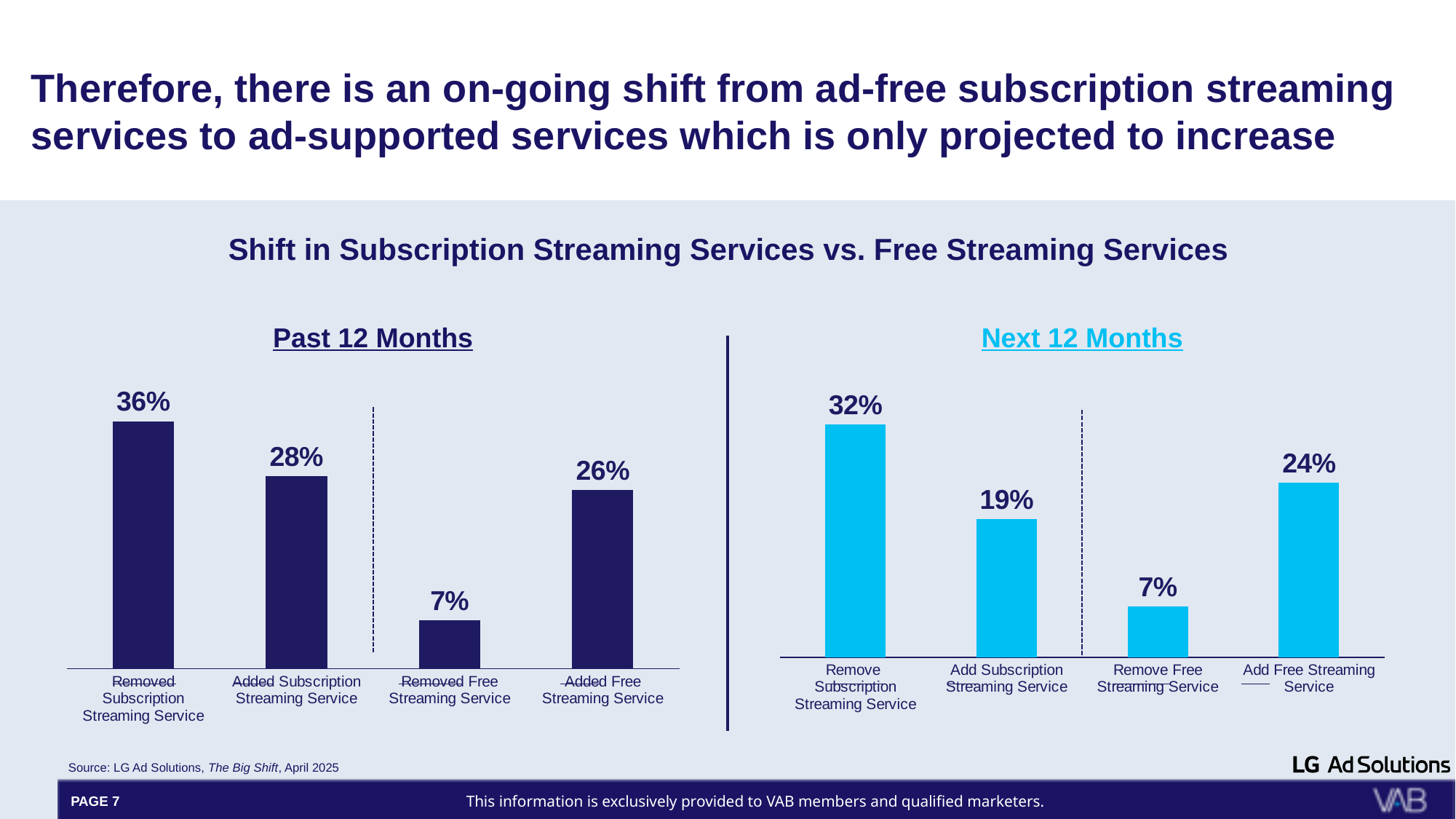
What colour are the bars in the Next 12 Months chart? Light blue In the Past 12 Months chart, which is larger: Added Subscription Streaming Service or Added Free Streaming Service? Added Subscription Streaming Service How many categories are shown in the Past 12 Months chart? 4 In the Next 12 Months chart, which is larger: Remove Subscription Streaming Service or Add Free Streaming Service? Remove Subscription Streaming Service What kind of chart is the Next 12 Months chart? Bar chart In the Past 12 Months chart, what is the value for Removed Subscription Streaming Service? 36% In the Next 12 Months chart, which category has the highest value? Remove Subscription Streaming Service In the Past 12 Months chart, which category has the lowest value? Removed Free Streaming Service In the Next 12 Months chart, what is the value for Add Free Streaming Service? 24% In the Next 12 Months chart, what is the difference between Add Free Streaming Service and Add Subscription Streaming Service? 5% What is the overall title above the two charts? Shift in Subscription Streaming Services vs. Free Streaming Services In the Past 12 Months chart, what is the difference between Removed Subscription Streaming Service and Added Subscription Streaming Service? 8%